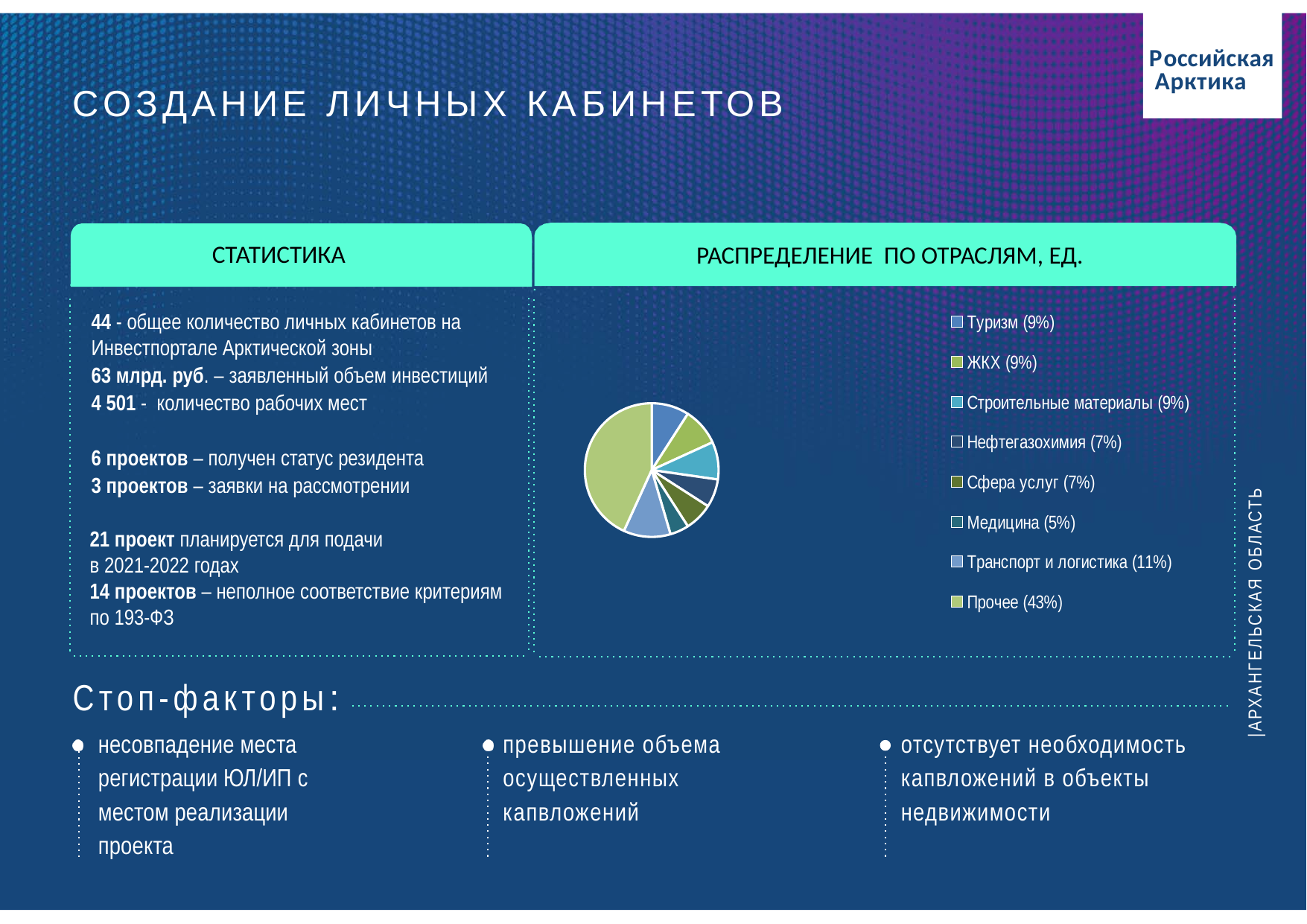
What is the difference in percentage points between "ЖКХ" and "Медицина" in the pie chart? 4 What percentage is shown for "Прочее" in the pie chart legend? 43% What kind of chart is shown under the heading "РАСПРЕДЕЛЕНИЕ ПО ОТРАСЛЯМ, ЕД."? pie chart What is the title of the panel containing the pie chart? РАСПРЕДЕЛЕНИЕ ПО ОТРАСЛЯМ, ЕД. What is the difference in percentage points between "Прочее" and "Транспорт и логистика" in the pie chart? 32 Which has the larger share in the pie chart, "Медицина" or "Сфера услуг"? Сфера услуг What share of the pie chart does "Транспорт и логистика" account for? 11% How many categories does the legend of the pie chart list? 8 Which category has the smallest share in the pie chart? Медицина What percentage is shown for "Туризм" in the pie chart legend? 9% What percentage is shown for "Нефтегазохимия" in the pie chart legend? 7% Which category has the largest share in the pie chart? Прочее